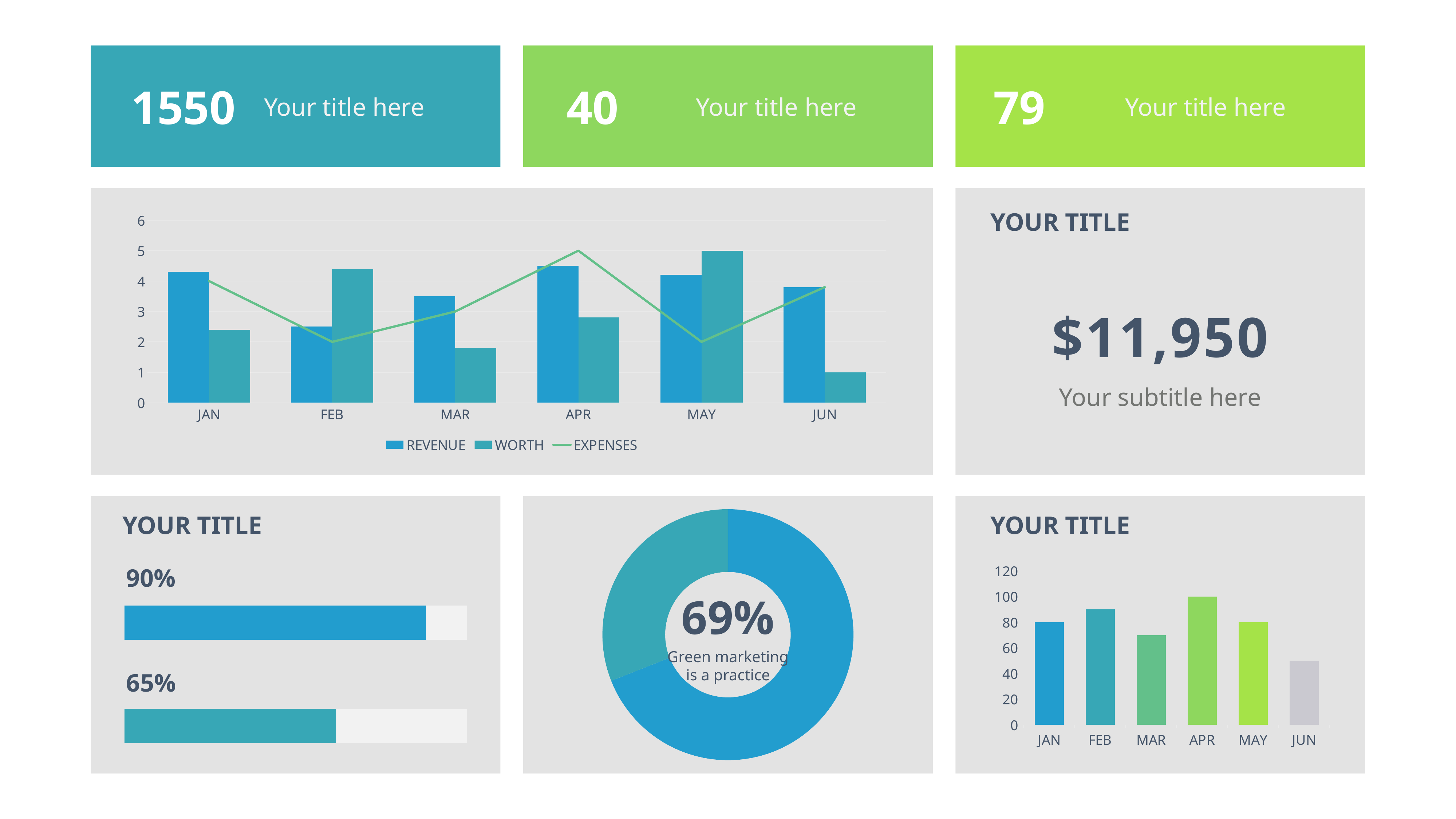
In the bottom-right bar chart, what is the value for APR? 100 In the top-left chart, how many series does the legend list? 3 In the top-left chart, what is the WORTH value for JUN? 1 In the top-left chart, is the REVENUE value for JAN or FEB larger? JAN In the top-left chart, which month has the highest WORTH value? MAY In the top-left chart, how many months are shown on the x axis? 6 In the top-left chart, what is the EXPENSES value for APR? 5 In the top-left chart, is the REVENUE value for FEB greater or less than 3? less What kind of chart is the top-left chart? Combined bar and line chart What percentage is shown in the centre of the donut chart at the bottom middle of the slide? 69% In the bottom-right bar chart, which month has the lowest value? JUN